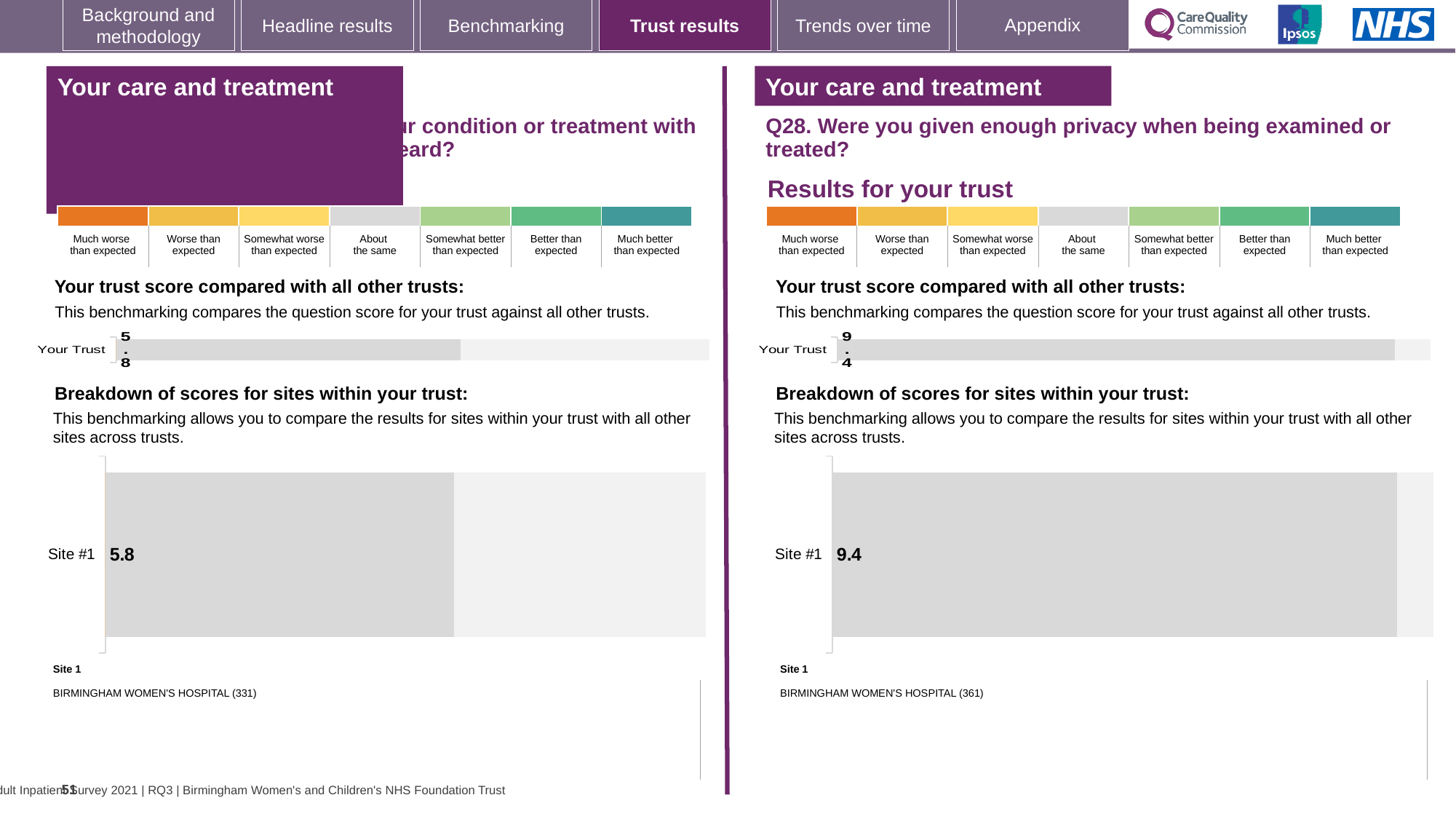
Which is larger: the Site #1 score on the left-hand chart or the Site #1 score on the right-hand chart for Q28? Right-hand chart (Q28) On the left-hand chart, what is the score shown for Your Trust? 5.8 On the right-hand chart for Q28, what is the score shown for Site #1? 9.4 What is the difference between the Site #1 score on the right-hand chart for Q28 and the Site #1 score on the left-hand chart? 3.6 On the left-hand chart, what is the score shown for Site #1? 5.8 On the right-hand panel for Q28, which hospital is listed as Site 1? BIRMINGHAM WOMEN'S HOSPITAL (361) On the right-hand chart for Q28 (privacy when being examined or treated), what is the score shown for Your Trust? 9.4 How many sites are shown in the breakdown of scores on the right-hand chart for Q28? 1 On the left-hand panel, which hospital is listed as Site 1? BIRMINGHAM WOMEN'S HOSPITAL (331) On the right-hand chart for Q28, is the Your Trust score the same as the Site #1 score? Yes What type of chart is used to show the Site #1 score on the right-hand panel for Q28? Bar chart